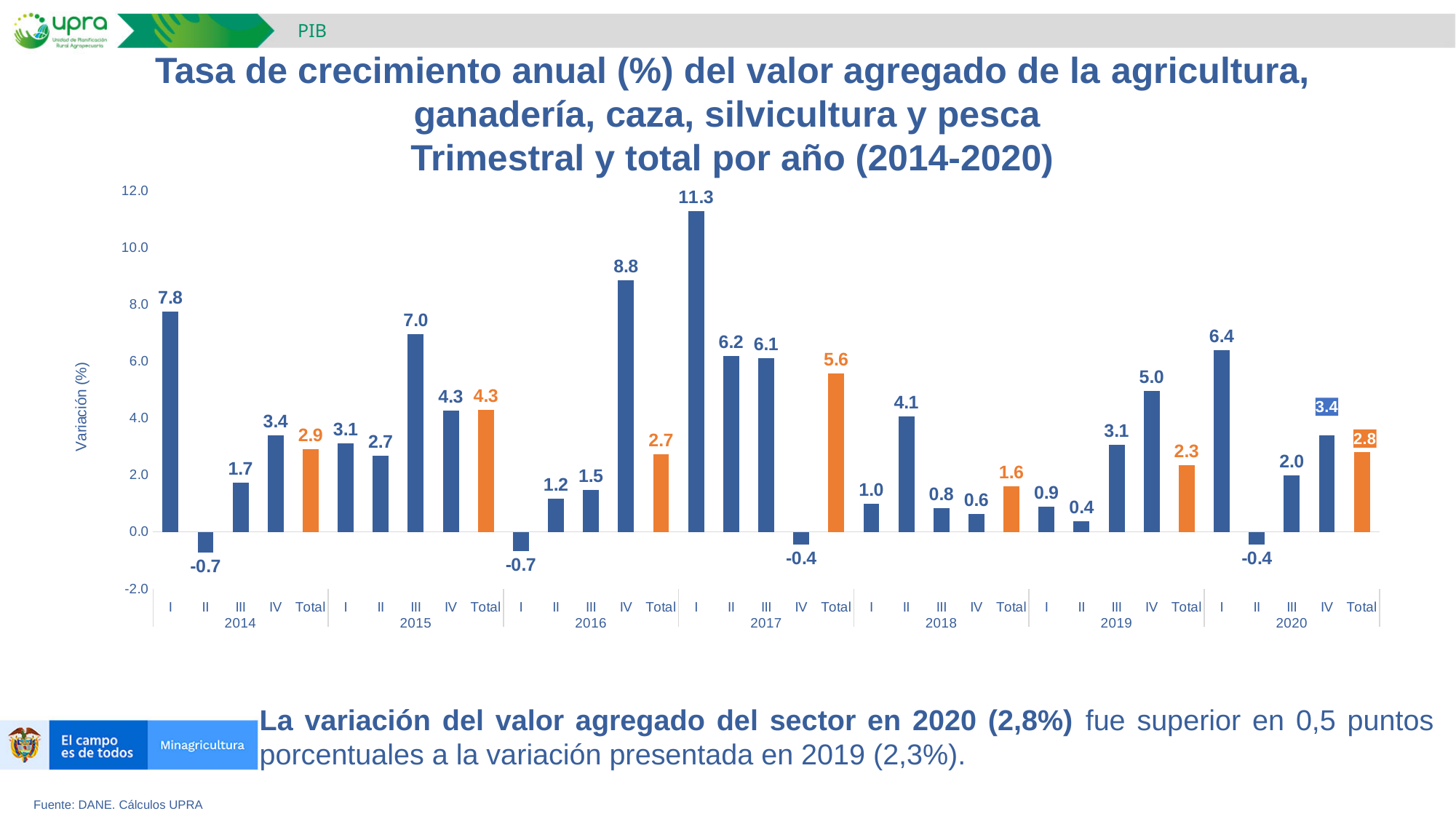
What is the difference between the annual total for 2020 and the annual total for 2019? 0.5 What is the value for quarter II of 2020? -0.4 What is the value for quarter IV of 2016? 8.8 What colour are the annual total bars? Orange Which year has the lowest annual total value? 2018 What type of chart is shown on the slide? Bar chart Which year has the highest annual total value? 2017 What is the value for quarter I of 2017? 11.3 Which bar has the highest value in the chart? I 2017 How many bars are plotted in the chart? 35 What is the annual total value for 2018? 1.6 Which is larger, the value for quarter III of 2015 or the value for quarter I of 2020? III 2015